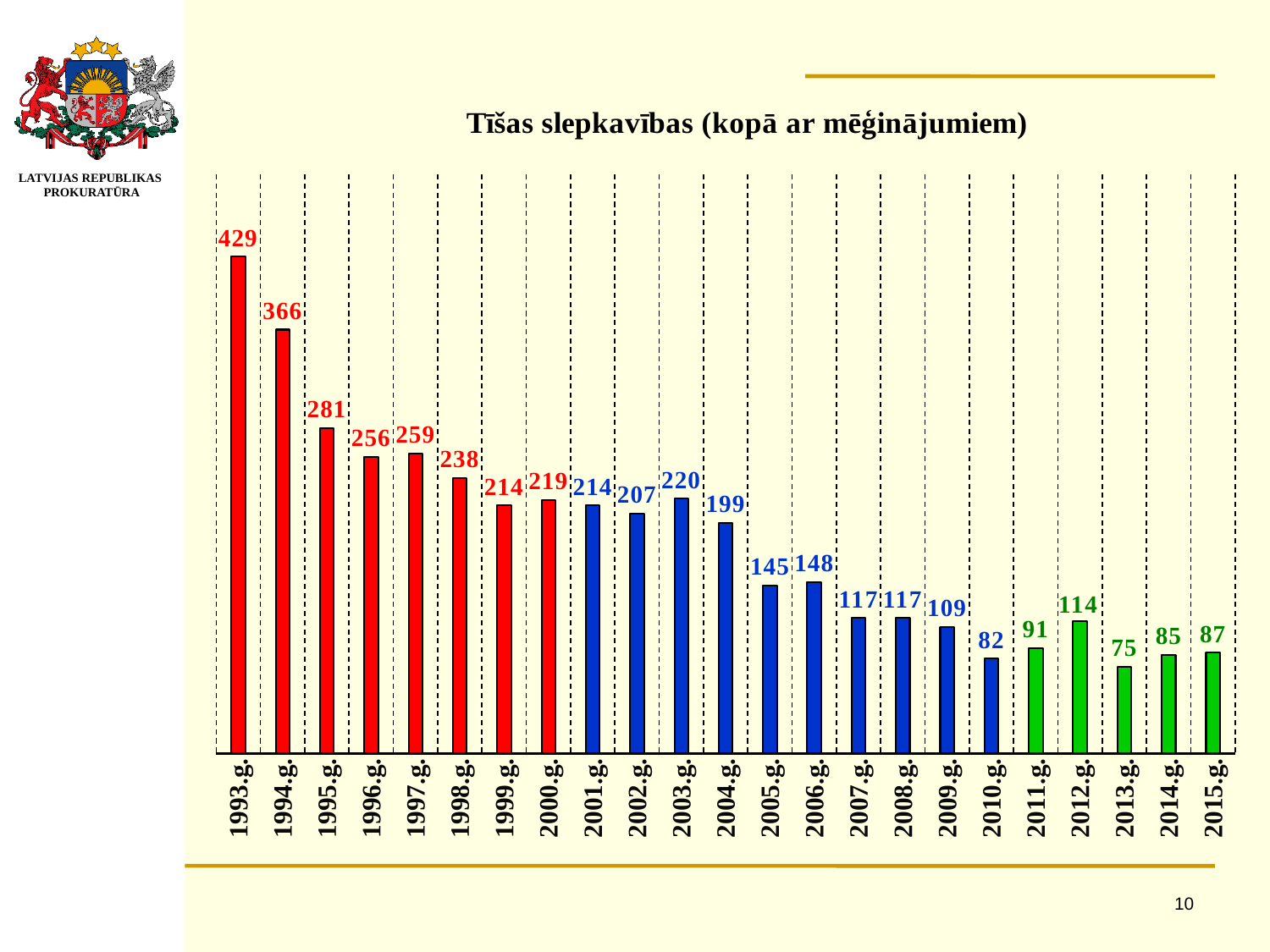
What is the value for 2003.g.? 220 Which is larger, the value for 1996.g. or the value for 1997.g.? 1997.g. How many years are shown on the x axis? 23 What kind of chart is shown on the slide? bar chart What is the difference between the values for 1993.g. and 1994.g.? 63 Which year has the lowest value? 2013.g. What is the value for 2015.g.? 87 What is the value for 2010.g.? 82 What is the difference between the values for 2012.g. and 2013.g.? 39 Which year has the highest value? 1993.g. What is the value for 1993.g.? 429 Do the values generally rise or fall from 1993.g. to 2015.g.? fall